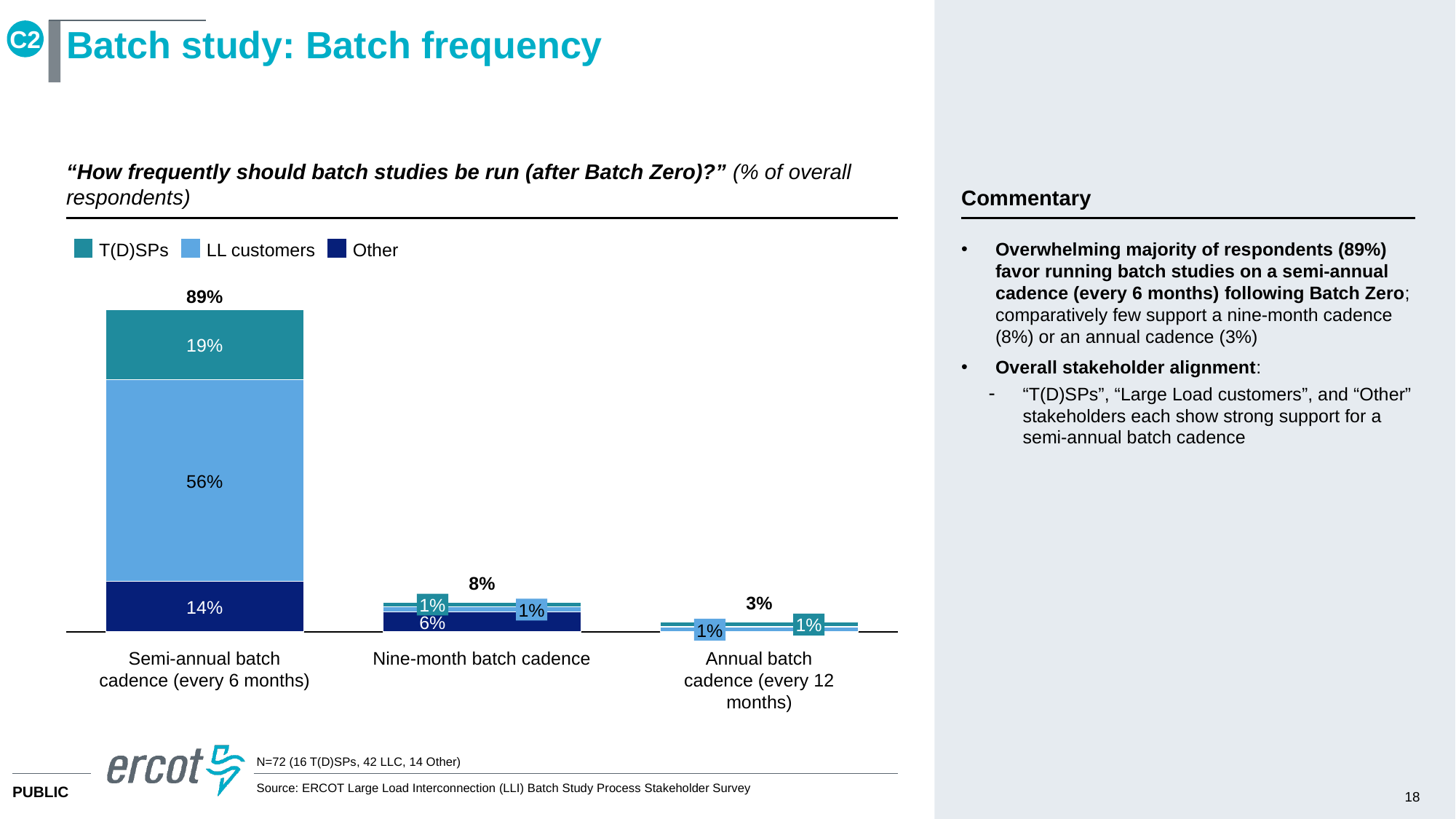
What is the Other value for Nine-month batch cadence? 6% What is the LL customers value for Semi-annual batch cadence (every 6 months)? 56% What is the T(D)SPs value for Semi-annual batch cadence (every 6 months)? 19% What is the total percentage for the Annual batch cadence (every 12 months) bar? 3% What is the difference between the LL customers value and the Other value for Semi-annual batch cadence (every 6 months)? 42% Which batch cadence has the highest overall percentage of respondents? Semi-annual batch cadence (every 6 months) Which batch cadence has the lowest overall percentage of respondents? Annual batch cadence (every 12 months) What kind of chart is shown on the slide? Stacked bar chart How many series does the legend list? 3 Which is larger for Semi-annual batch cadence (every 6 months): the T(D)SPs value or the Other value? T(D)SPs How many batch cadence categories are shown on the x axis? 3 What is the total percentage for the Semi-annual batch cadence (every 6 months) bar? 89%